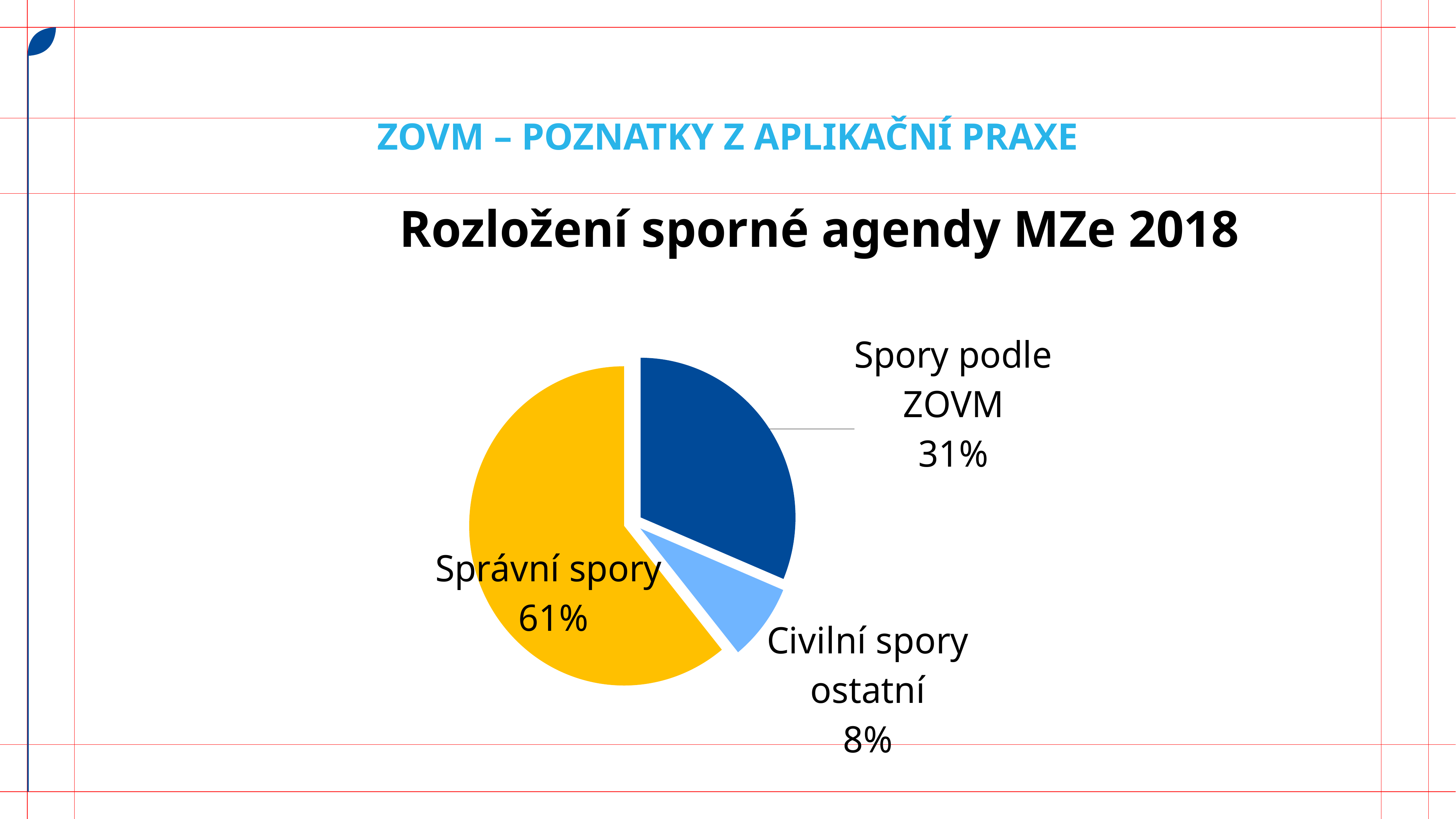
What is the title of the chart? Rozložení sporné agendy MZe 2018 What is the difference in percentage points between Správní spory and Spory podle ZOVM? 30 What share of the pie does Spory podle ZOVM have? 31% What share of the pie does Civilní spory ostatní have? 8% Which is larger, Spory podle ZOVM or Civilní spory ostatní? Spory podle ZOVM What is the difference in percentage points between Spory podle ZOVM and Civilní spory ostatní? 23 Which category has the largest slice of the pie? Správní spory What colour is the Správní spory slice? Yellow What kind of chart is shown on the slide? Pie chart What share of the pie does Správní spory have? 61% Which category has the smallest slice of the pie? Civilní spory ostatní How many categories does the pie chart show? 3